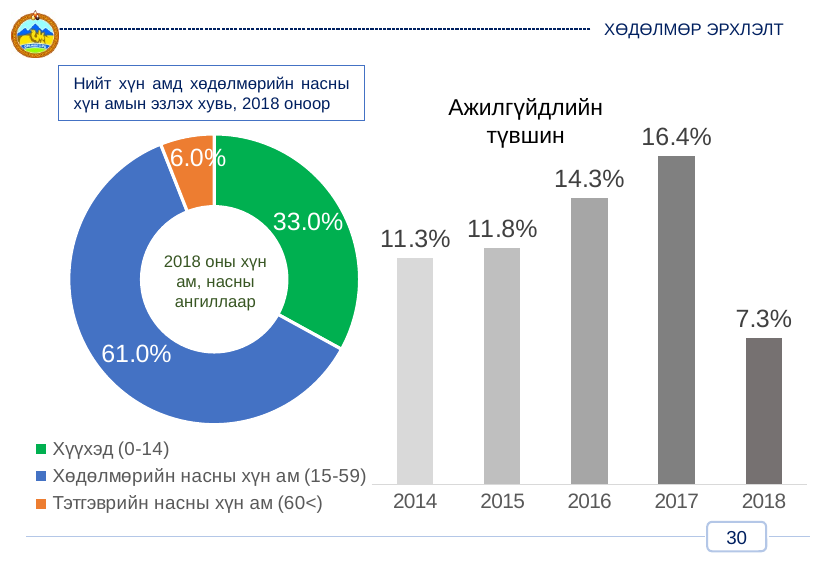
In the bar chart titled "Ажилгүйдлийн түвшин", which year has the highest value? 2017 In the bar chart titled "Ажилгүйдлийн түвшин", which is larger, the value for 2015 or the value for 2016? 2016 What kind of chart is the chart on the right of the slide, titled "Ажилгүйдлийн түвшин"? Bar chart In the bar chart titled "Ажилгүйдлийн түвшин", what is the difference between the values for 2017 and 2018? 9.1% In the bar chart titled "Ажилгүйдлийн түвшин", how many years are shown on the x axis? 5 In the doughnut chart on the left of the slide, what is the value for "Тэтгэврийн насны хүн ам (60<)"? 6.0% In the bar chart titled "Ажилгүйдлийн түвшин", what is the value for 2017? 16.4% How many entries does the legend of the doughnut chart on the left of the slide list? 3 In the bar chart titled "Ажилгүйдлийн түвшин", do the values rise or fall from 2014 to 2017? Rise In the bar chart titled "Ажилгүйдлийн түвшин", which year has the lowest value? 2018 In the doughnut chart on the left of the slide, what share does "Хөдөлмөрийн насны хүн ам (15-59)" have? 61.0% In the bar chart titled "Ажилгүйдлийн түвшин", what is the value for 2014? 11.3%